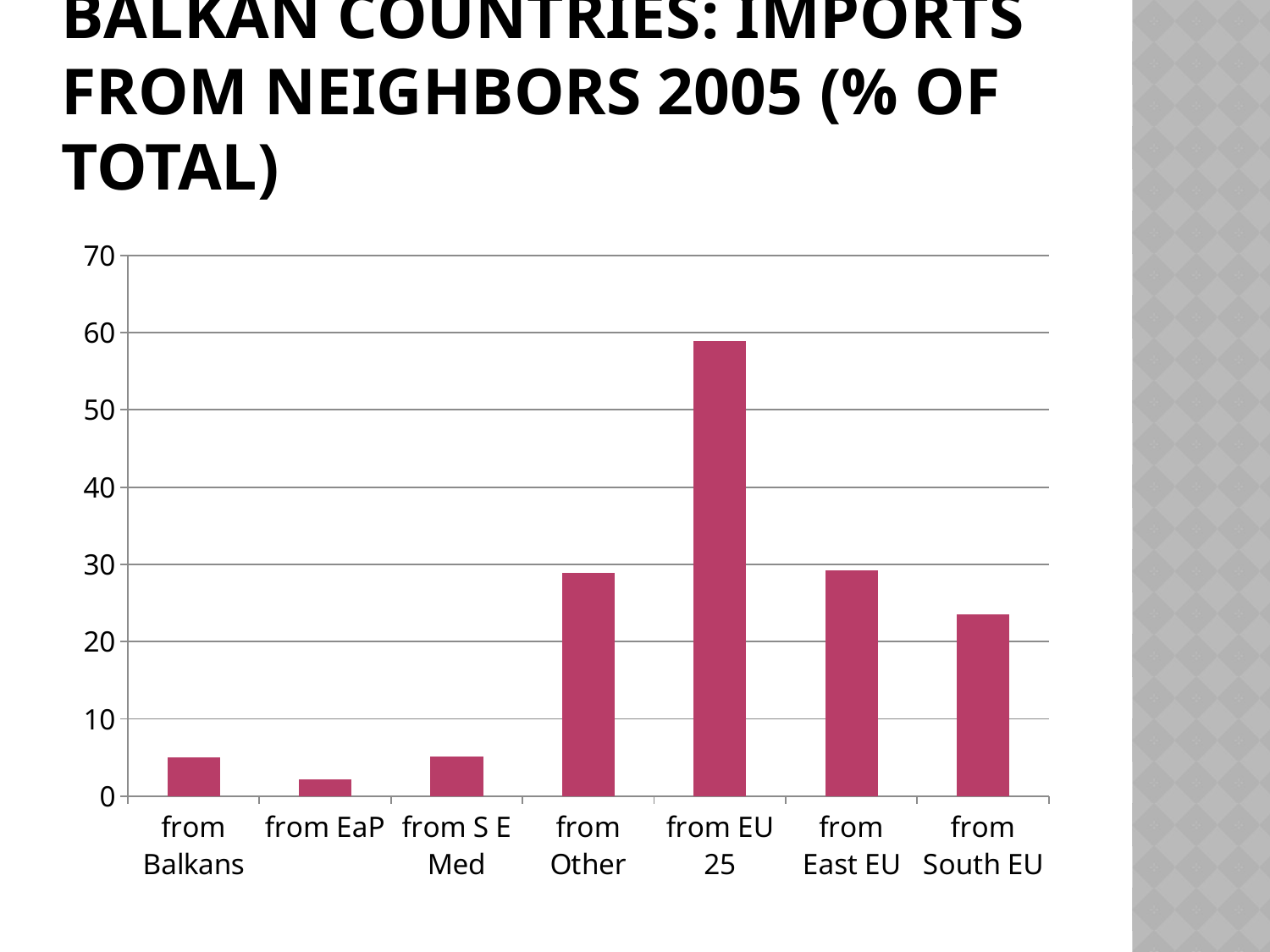
How many categories are shown on the x axis? 7 Which category has the highest value? from EU 25 Is the value for 'from Other' greater or less than 40? less Which is larger, the value for 'from EU 25' or the value for 'from East EU'? from EU 25 What is the title of the slide? Balkan Countries: Imports from Neighbors 2005 (% of Total) Which is larger, the value for 'from East EU' or the value for 'from South EU'? from East EU Is the value for 'from EU 25' greater or less than 50? greater Is the value for 'from EaP' greater or less than 10? less Which category has the lowest value? from EaP Which is larger, the value for 'from Other' or the value for 'from Balkans'? from Other What kind of chart is shown on the slide? bar chart